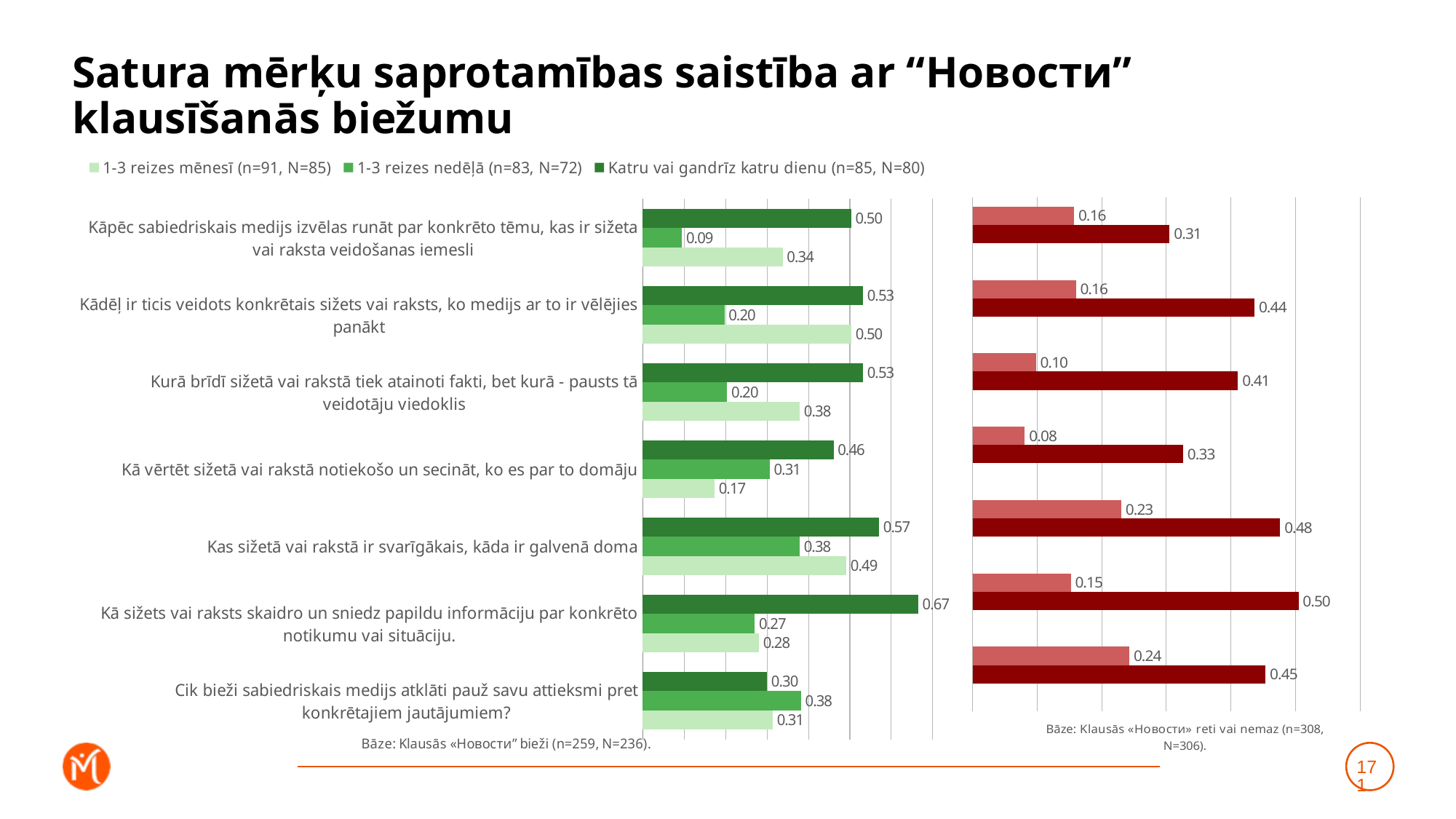
In the left-hand green chart, which category has the highest value for the 'Katru vai gandrīz katru dienu' series? Kā sižets vai raksts skaidro un sniedz papildu informāciju par konkrēto notikumu vai situāciju. In the left-hand green chart, for 'Cik bieži sabiedriskais medijs atklāti pauž savu attieksmi pret konkrētajiem jautājumiem?', which series has the larger value: '1-3 reizes nedēļā' or 'Katru vai gandrīz katru dienu'? 1-3 reizes nedēļā What base (Bāze) is stated below the left-hand green chart? Klausās «Новости» bieži (n=259, N=236) In the left-hand green chart, what is the '1-3 reizes mēnesī' value for 'Kā vērtēt sižetā vai rakstā notiekošo un secināt, ko es par to domāju'? 0.17 In the left-hand green chart, for 'Kas sižetā vai rakstā ir svarīgākais, kāda ir galvenā doma', what is the difference between the 'Katru vai gandrīz katru dienu' value and the '1-3 reizes nedēļā' value? 0.19 In the right-hand red chart, which row has the lowest value for the lighter red bar? Kā vērtēt sižetā vai rakstā notiekošo un secināt, ko es par to domāju How many categories (rows) are shown in the left-hand green chart? 7 What type of chart is the left-hand green chart? Bar chart How many series does the legend list for the left-hand green chart? 3 In the right-hand red chart, what is the value of the dark red bar in the row for 'Kā sižets vai raksts skaidro un sniedz papildu informāciju par konkrēto notikumu vai situāciju.'? 0.50 In the left-hand green chart, what is the value for 'Katru vai gandrīz katru dienu' for the category 'Kā sižets vai raksts skaidro un sniedz papildu informāciju par konkrēto notikumu vai situāciju.'? 0.67 In the left-hand green chart, which category has the lowest value for the '1-3 reizes nedēļā' series? Kāpēc sabiedriskais medijs izvēlas runāt par konkrēto tēmu, kas ir sižeta vai raksta veidošanas iemesli